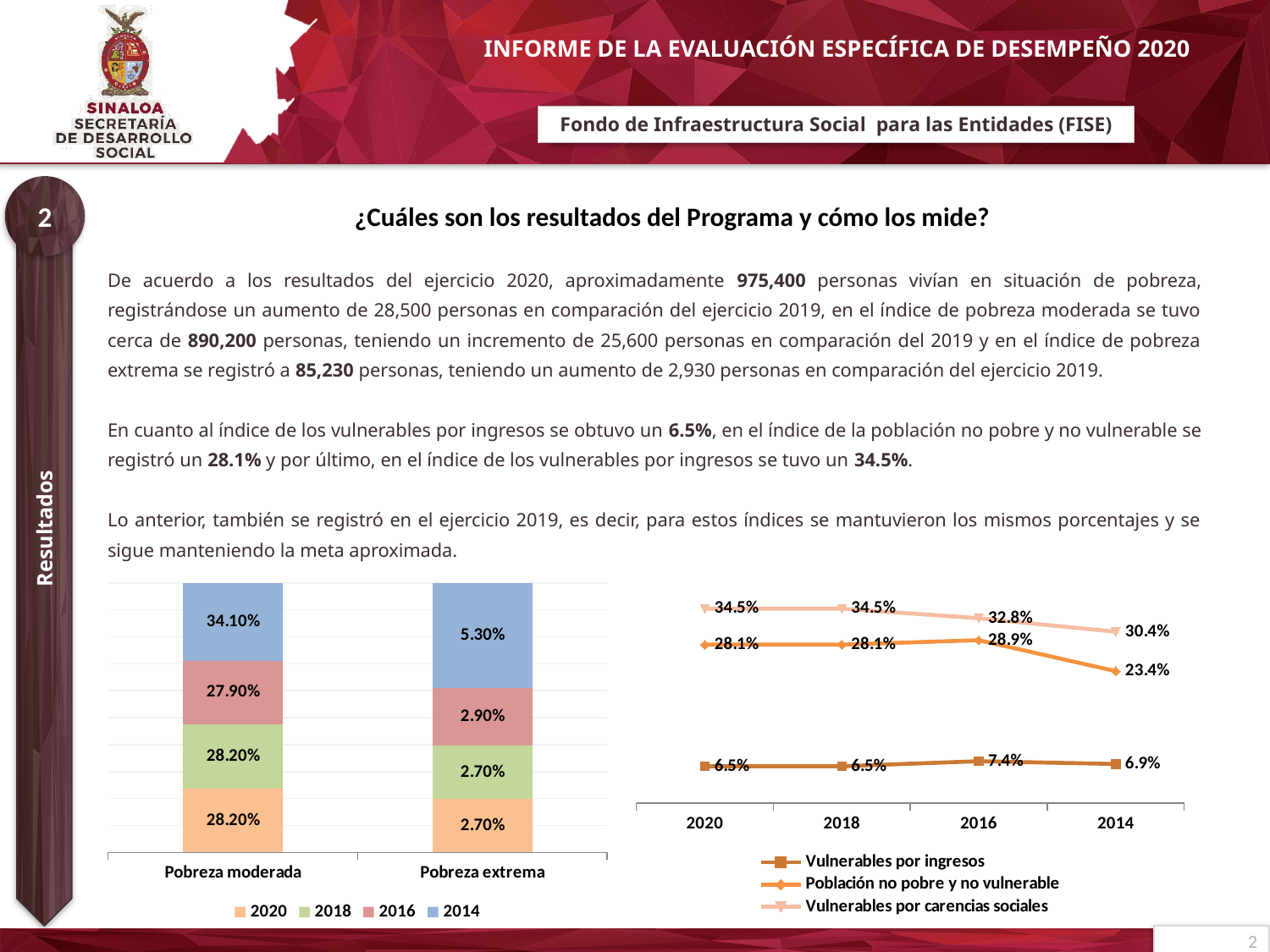
In the right line chart, do the values for Vulnerables por carencias sociales rise or fall from left to right along the x axis? Fall In the right line chart, what is the value of Vulnerables por ingresos for 2016? 7.4% What kind of chart is the chart on the left of the slide? Stacked bar chart In the left stacked bar chart, what is the 2014 value for Pobreza moderada? 34.10% In the right line chart, how many series does the legend list? 3 In the left stacked bar chart, what is the total of the stacked bar for Pobreza extrema? 13.60% In the right line chart, which is larger: Población no pobre y no vulnerable in 2016 or in 2014? 2016 In the right line chart, what is the value of Vulnerables por carencias sociales for 2014? 30.4% In the left stacked bar chart, what is the difference between the 2014 and 2016 values for Pobreza moderada? 6.20% In the right line chart, which year has the lowest value for Población no pobre y no vulnerable? 2014 In the left stacked bar chart, how many series does the legend list? 4 In the left stacked bar chart, what is the 2016 value for Pobreza extrema? 2.90%